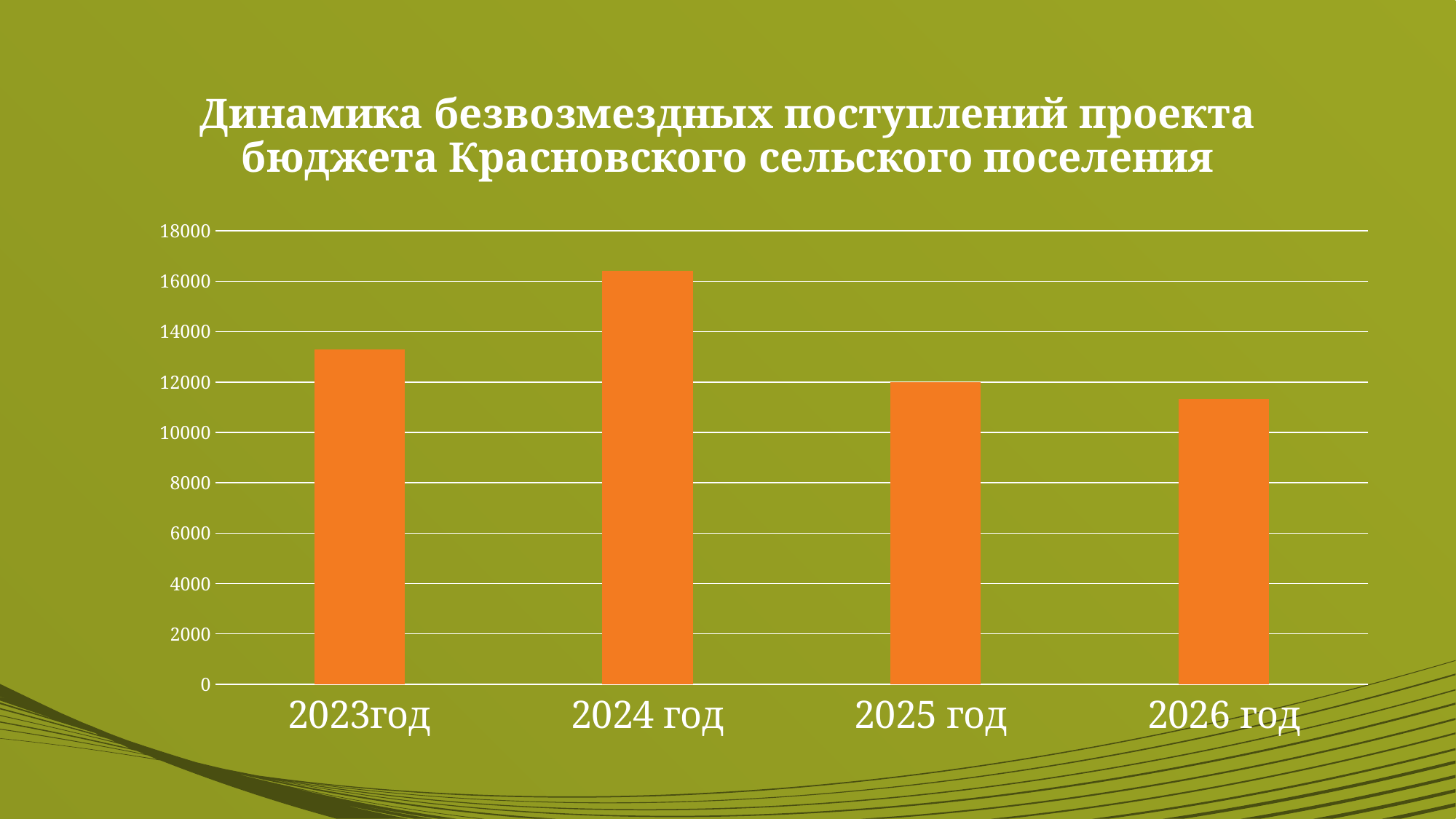
Do the values rise or fall from 2024 год to 2026 год? fall Is the value for 2023 год greater or less than 14000? less Which year has the highest value? 2024 год Is the value for 2025 год greater or less than 10000? greater Is the value for 2024 год greater or less than 16000? greater What kind of chart is shown on the slide? bar chart How many years (categories) are shown on the x axis? 4 What colour are the bars in the chart? orange Which year has the lowest value? 2026 год Which is larger, the value for 2023 год or the value for 2025 год? 2023 год What is the title of the chart? Динамика безвозмездных поступлений проекта бюджета Красновского сельского поселения